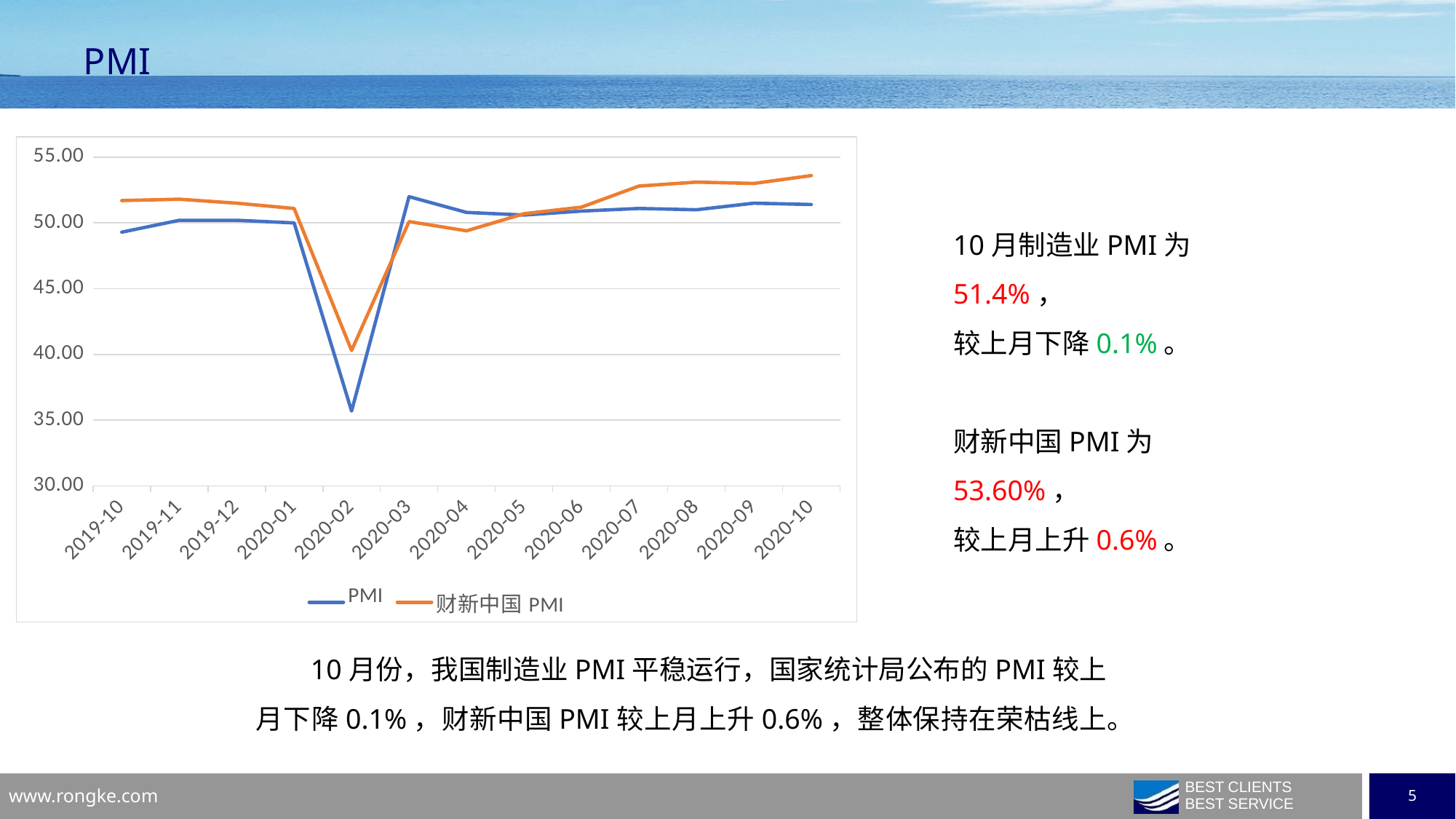
According to the slide, what is the manufacturing PMI for October 2020? 51.4% How many months are plotted along the x axis? 13 What kind of chart is shown on the slide? line chart In 2020-10, which series has the higher value, PMI or 财新中国 PMI? 财新中国 PMI How many series does the legend list? 2 In which month does the PMI series reach its lowest value? 2020-02 In which month does the 财新中国 PMI series reach its highest value? 2020-10 Is the value for 财新中国 PMI in 2020-10 greater or less than 50.00? greater According to the slide, what is the 财新中国 PMI for October 2020? 53.60% In 2020-02, which series has the lower value, PMI or 财新中国 PMI? PMI In which month does the 财新中国 PMI series reach its lowest value? 2020-02 Is the value for PMI in 2020-02 greater or less than 40.00? less